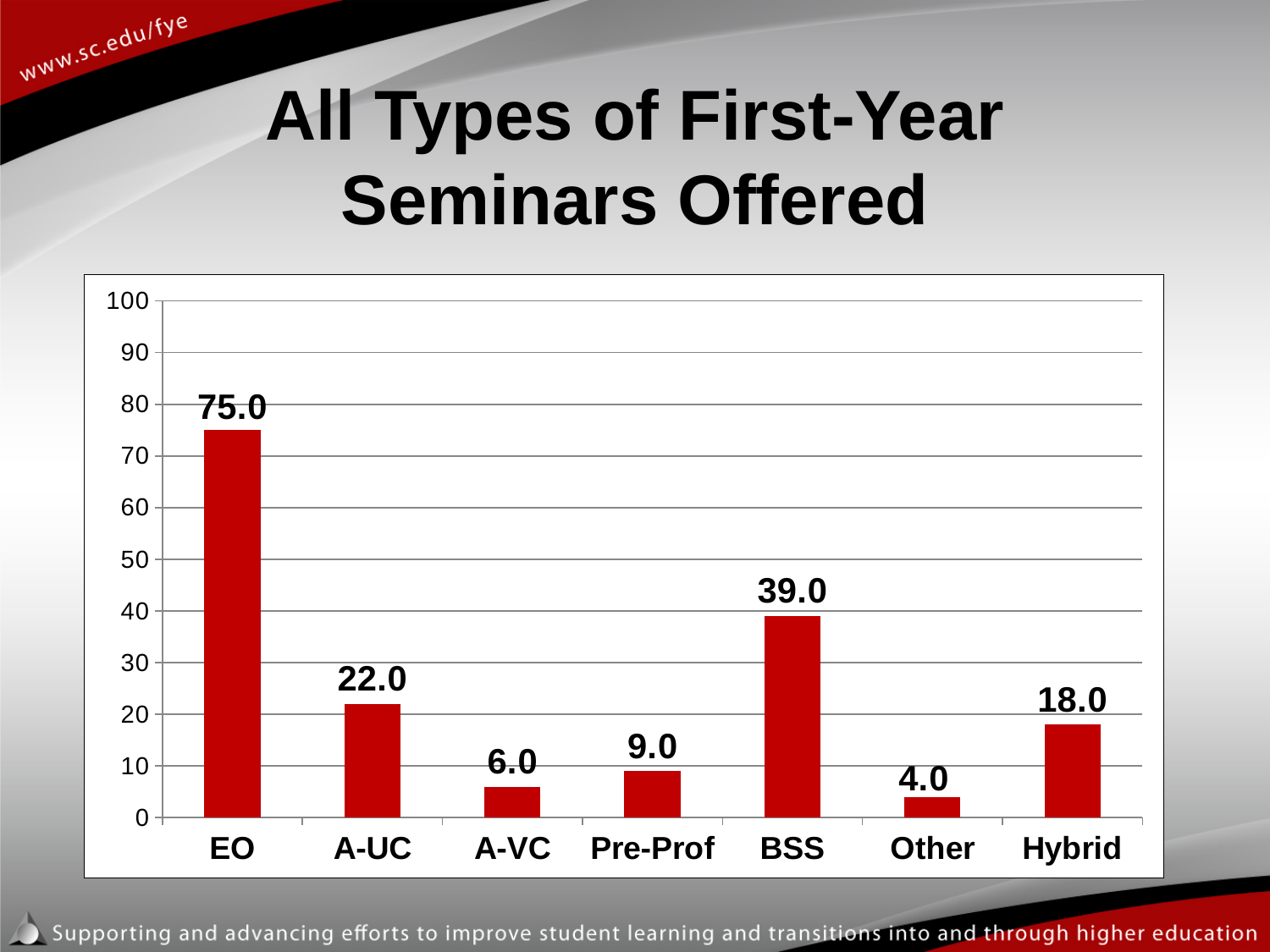
What is the difference between the values for EO and BSS? 36.0 Which category has the lowest value? Other What is the value for BSS? 39.0 What kind of chart is shown on the slide? bar chart Which category has the highest value? EO How many categories are shown on the x axis? 7 What is the difference between the values for A-UC and Hybrid? 4.0 What is the value for Hybrid? 18.0 What is the value for EO? 75.0 What is the value for Pre-Prof? 9.0 Which is larger, the value for A-UC or the value for Hybrid? A-UC Is the value for BSS greater or less than 50? less